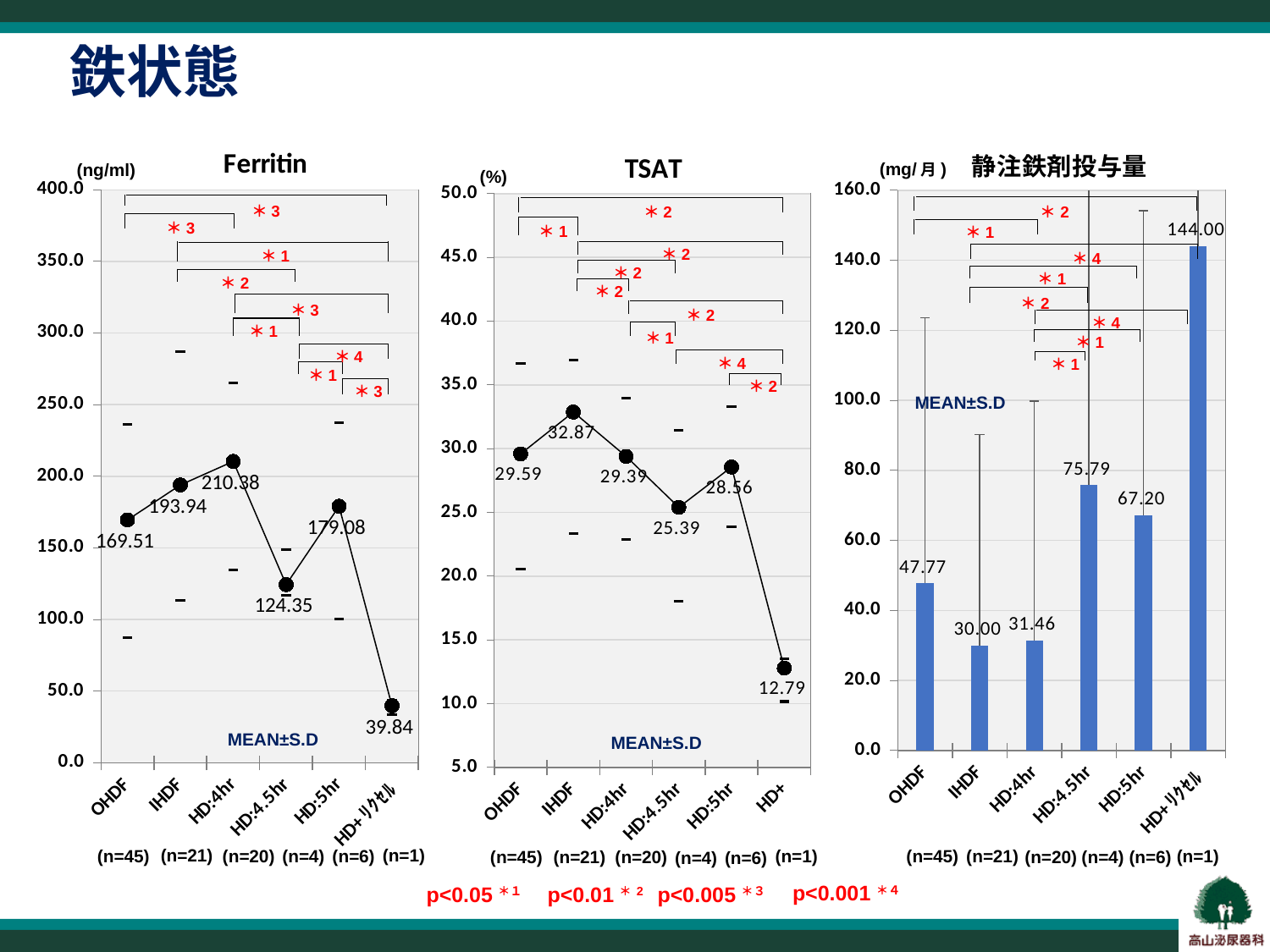
In the 静注鉄剤投与量 chart, what is the difference between the values for HD+リクセル and OHDF? 96.23 In the Ferritin chart, which category has the lowest value? HD+リクセル How many categories are shown on the x axis of the TSAT chart? 6 In the 静注鉄剤投与量 chart, what is the value for HD:4.5hr? 75.79 In the 静注鉄剤投与量 chart, which category has the highest value? HD+リクセル What unit is shown on the y axis of the Ferritin chart? ng/ml What kind of chart is the 静注鉄剤投与量 chart? Bar chart In the TSAT chart, which category has the highest value? IHDF In the TSAT chart, which is larger, the value for OHDF or the value for HD:5hr? OHDF In the Ferritin chart, what is the difference between the values for HD:4hr and HD:4.5hr? 86.03 In the Ferritin chart, what is the value for HD:4hr? 210.38 In the TSAT chart, what is the value for IHDF? 32.87